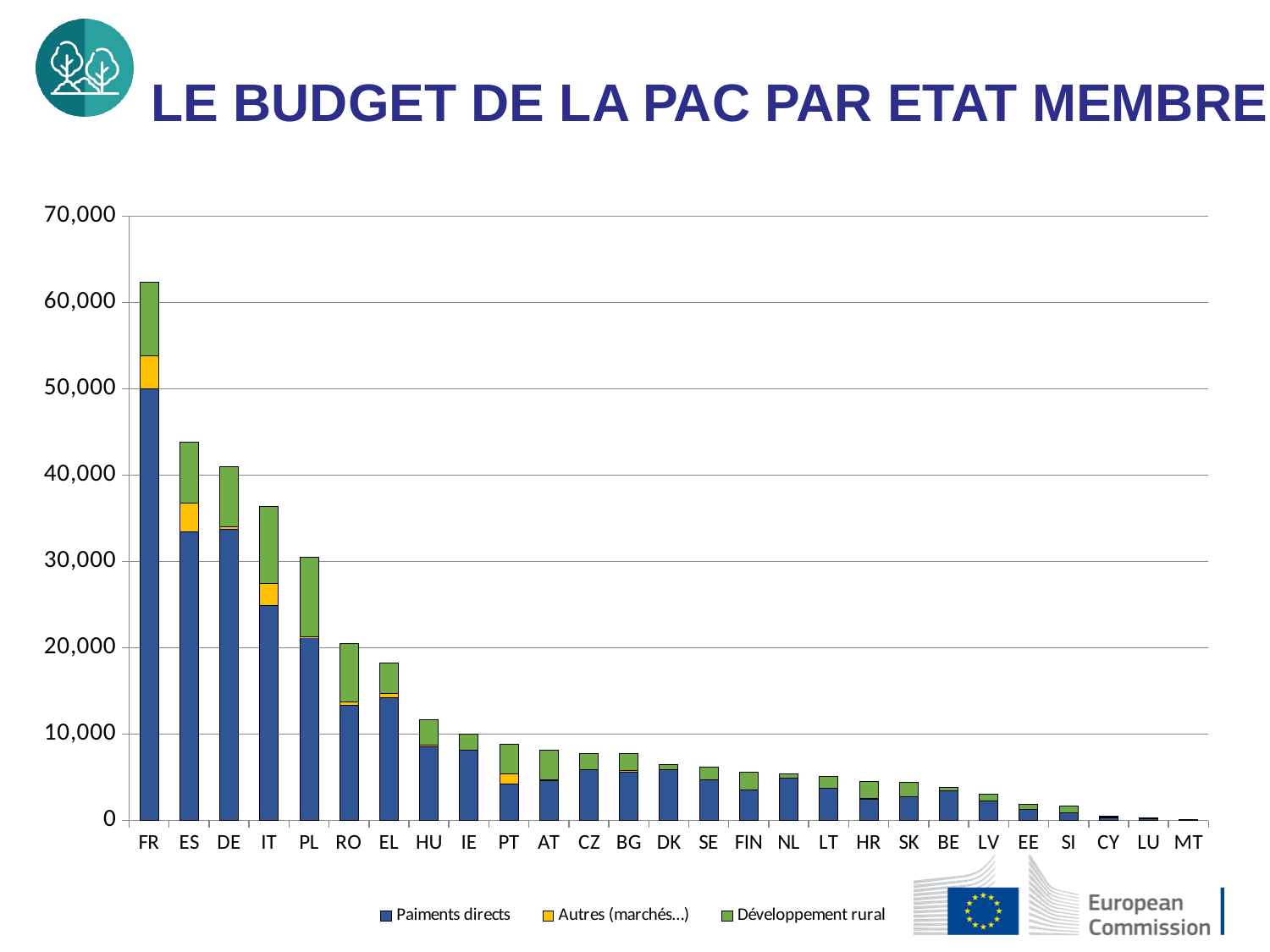
What kind of chart is shown on the slide? Stacked bar chart Is the total value for FR greater or less than 60,000? greater Is the total value for HU greater or less than 10,000? greater Which series is shown in green in the legend? Développement rural Which has the larger total CAP budget, ES or DE? ES Which member state has the highest total CAP budget? FR Is the total value for EL greater or less than 20,000? less Do the total values rise or fall moving from left to right along the x axis? fall Which member state has the lowest total CAP budget? MT How many series does the legend list? 3 How many member states (categories) are shown on the x axis? 27